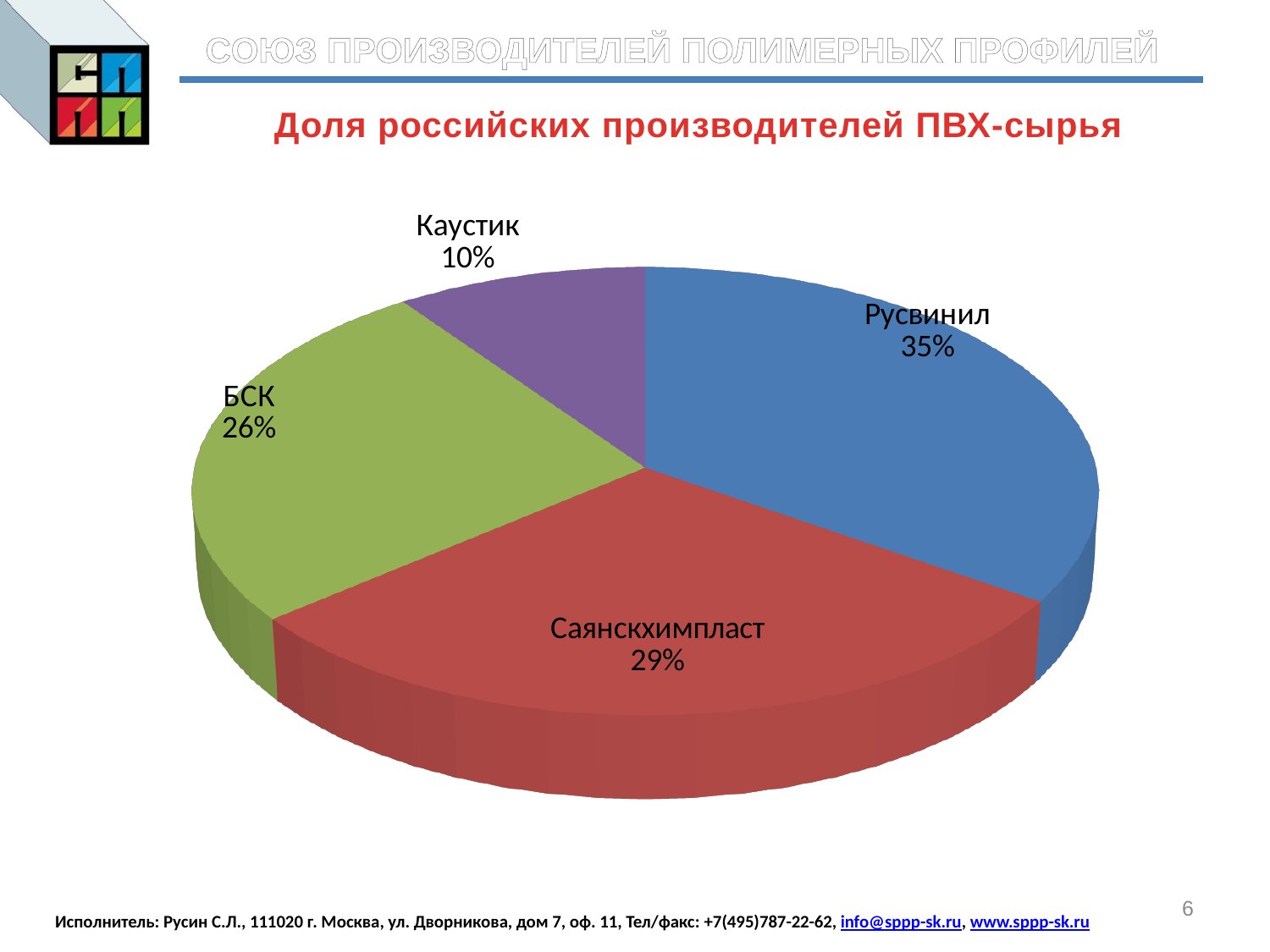
What share of the pie does Русвинил hold? 35% What kind of chart is shown on the slide? Pie chart Which producer has the smallest share? Каустик What is the title of the chart? Доля российских производителей ПВХ-сырья What share of the pie does БСК hold? 26% Which producer has the largest share? Русвинил Which has a larger share, БСК or Саянскхимпласт? Саянскхимпласт What share of the pie does Каустик hold? 10% What is the difference in percentage points between Саянскхимпласт and БСК? 3 What is the difference in percentage points between Русвинил and Каустик? 25 What share of the pie does Саянскхимпласт hold? 29% How many producers are shown in the pie chart? 4